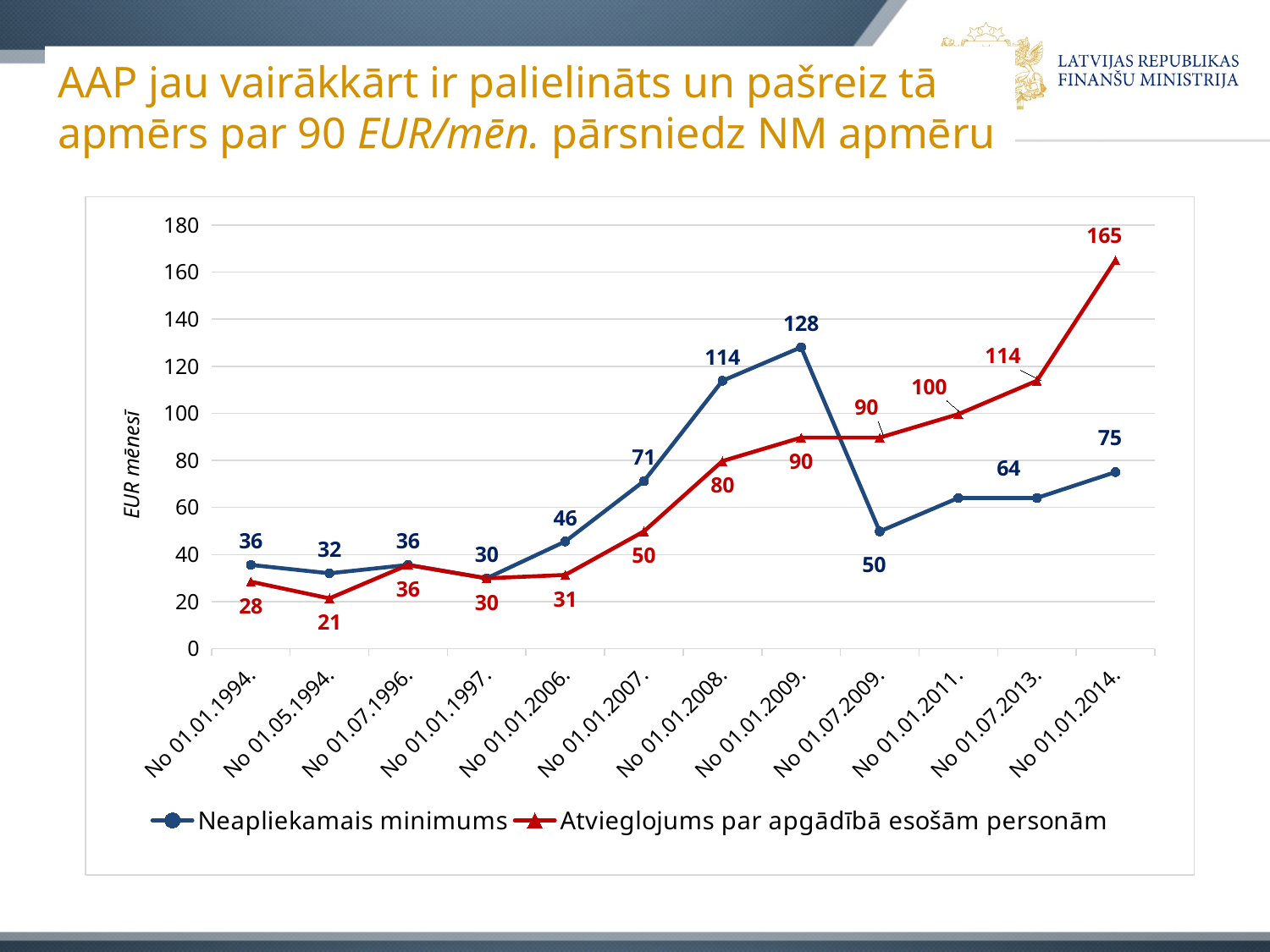
How many dates are shown on the x axis? 12 How many series does the legend list? 2 What is the value of Atvieglojums par apgādībā esošām personām at No 01.05.1994.? 21 What is the value of Neapliekamais minimums at No 01.01.2009.? 128 What is the value of Atvieglojums par apgādībā esošām personām at No 01.01.2014.? 165 At No 01.01.2008., which series has the larger value: Neapliekamais minimums or Atvieglojums par apgādībā esošām personām? Neapliekamais minimums At which date is Atvieglojums par apgādībā esošām personām lowest? No 01.05.1994. What is the difference between Atvieglojums par apgādībā esošām personām and Neapliekamais minimums at No 01.01.2014.? 90 What type of chart is shown on the slide? line chart Does Atvieglojums par apgādībā esošām personām rise or fall between No 01.07.2009. and No 01.01.2014.? rise What is the label of the y axis? EUR mēnesī At which date is Neapliekamais minimums highest? No 01.01.2009.